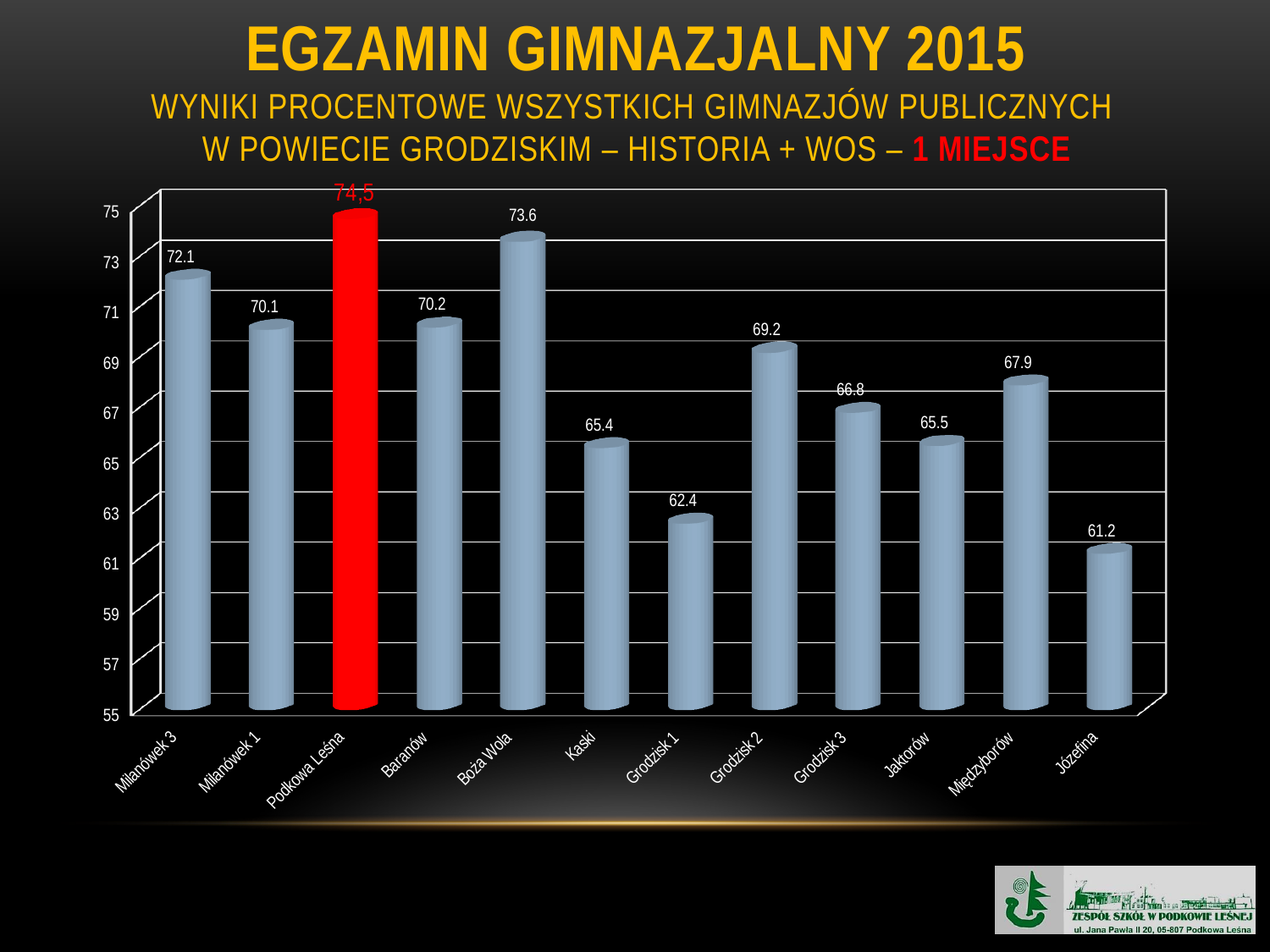
What is the value for Międzyborów? 67.9 How many schools (categories) are shown on the chart? 12 What is the value for Milanówek 3? 72.1 Which bar is coloured red on the chart? Podkowa Leśna What is the value for Boża Wola? 73.6 Which school has the lowest value on the chart? Józefina What type of chart is shown on the slide? bar chart What is the value for Grodzisk 1? 62.4 What is the difference between the values for Grodzisk 2 and Grodzisk 1? 6.8 Which school has the highest value on the chart? Podkowa Leśna What is the difference between the values for Boża Wola and Kaski? 8.2 Which has a larger value, Międzyborów or Grodzisk 3? Międzyborów